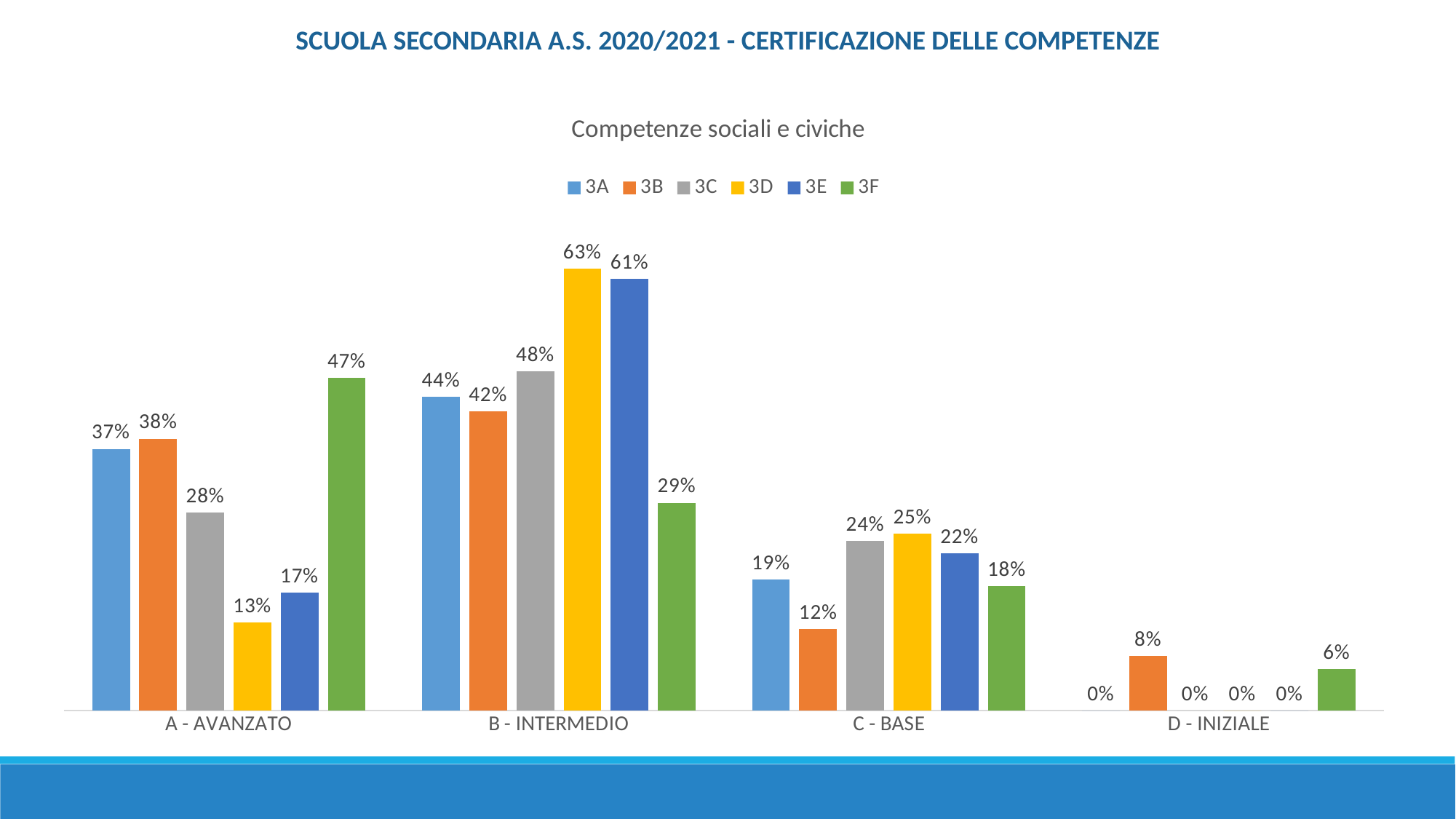
What is the difference between the 3F and 3A values in the A - AVANZATO category? 10% What is the difference between the 3D and 3E values in the B - INTERMEDIO category? 2% What kind of chart is shown on the slide? Bar chart How many series does the legend list? 6 In the C - BASE category, which is larger: the value for 3C or the value for 3B? 3C What is the value for 3F in the A - AVANZATO category? 47% Which series has the highest value in the B - INTERMEDIO category? 3D What is the value for 3B in the D - INIZIALE category? 8% What is the value for 3E in the C - BASE category? 22% Which series has the lowest value in the A - AVANZATO category? 3D How many categories are shown on the x axis? 4 What is the value for 3D in the B - INTERMEDIO category? 63%